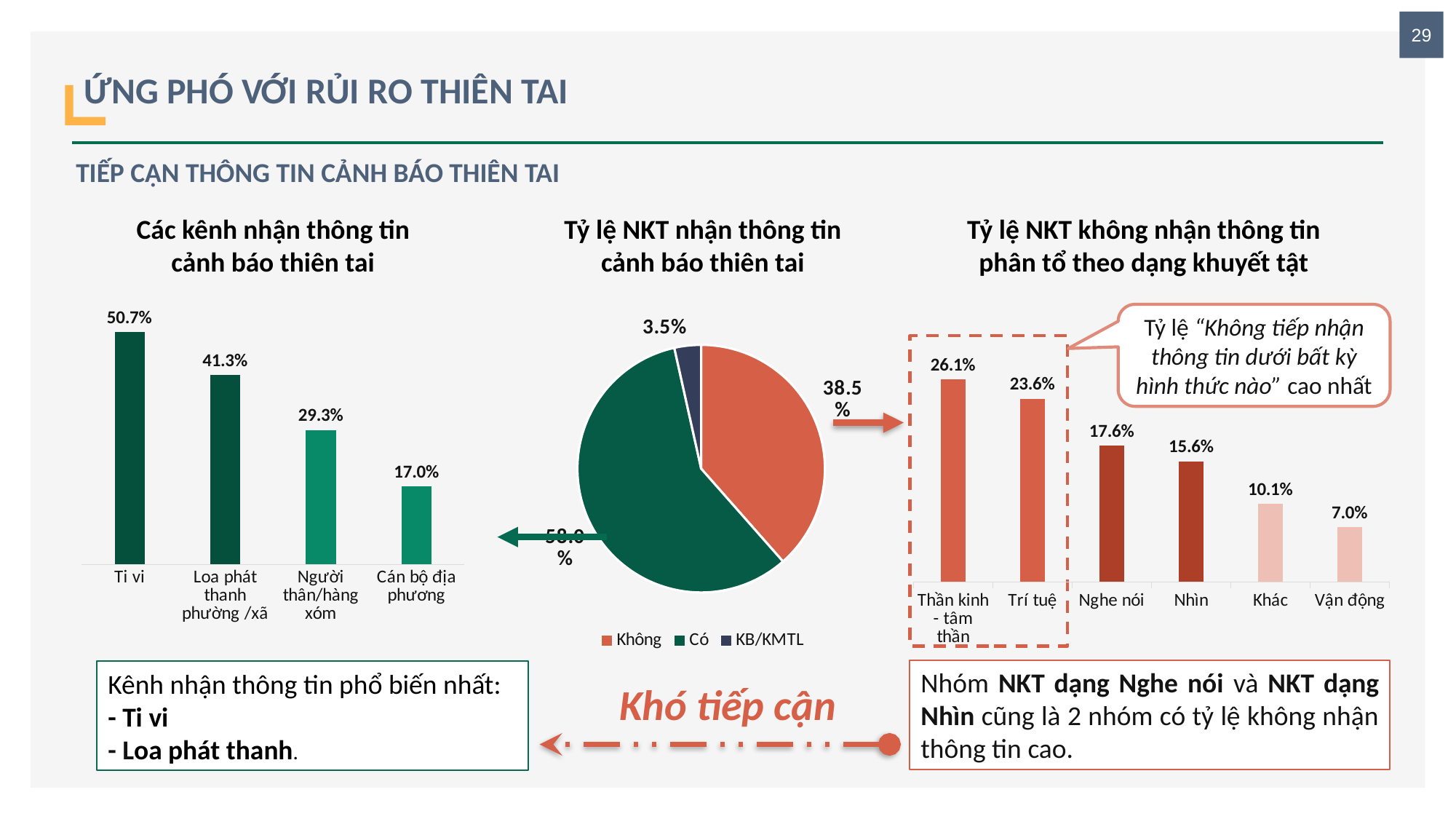
In the pie chart 'Tỷ lệ NKT nhận thông tin cảnh báo thiên tai', what share does Không have? 38.5% In the chart 'Các kênh nhận thông tin cảnh báo thiên tai', what is the difference between Ti vi and Loa phát thanh phường /xã? 9.4% In the pie chart 'Tỷ lệ NKT nhận thông tin cảnh báo thiên tai', what is the value for KB/KMTL? 3.5% In the chart 'Tỷ lệ NKT không nhận thông tin phân tổ theo dạng khuyết tật', what is the value for Nghe nói? 17.6% In the chart 'Tỷ lệ NKT không nhận thông tin phân tổ theo dạng khuyết tật', which category has the highest value? Thần kinh - tâm thần In the chart 'Tỷ lệ NKT không nhận thông tin phân tổ theo dạng khuyết tật', which is larger: Nhìn or Vận động? Nhìn How many categories are shown in the chart 'Các kênh nhận thông tin cảnh báo thiên tai'? 4 In the chart 'Các kênh nhận thông tin cảnh báo thiên tai', which category has the lowest value? Cán bộ địa phương In the chart 'Tỷ lệ NKT không nhận thông tin phân tổ theo dạng khuyết tật', do the values rise or fall from left to right? Fall How many entries does the legend of the pie chart 'Tỷ lệ NKT nhận thông tin cảnh báo thiên tai' list? 3 In the chart 'Các kênh nhận thông tin cảnh báo thiên tai', what is the value for Ti vi? 50.7% What kind of chart is 'Tỷ lệ NKT nhận thông tin cảnh báo thiên tai'? Pie chart